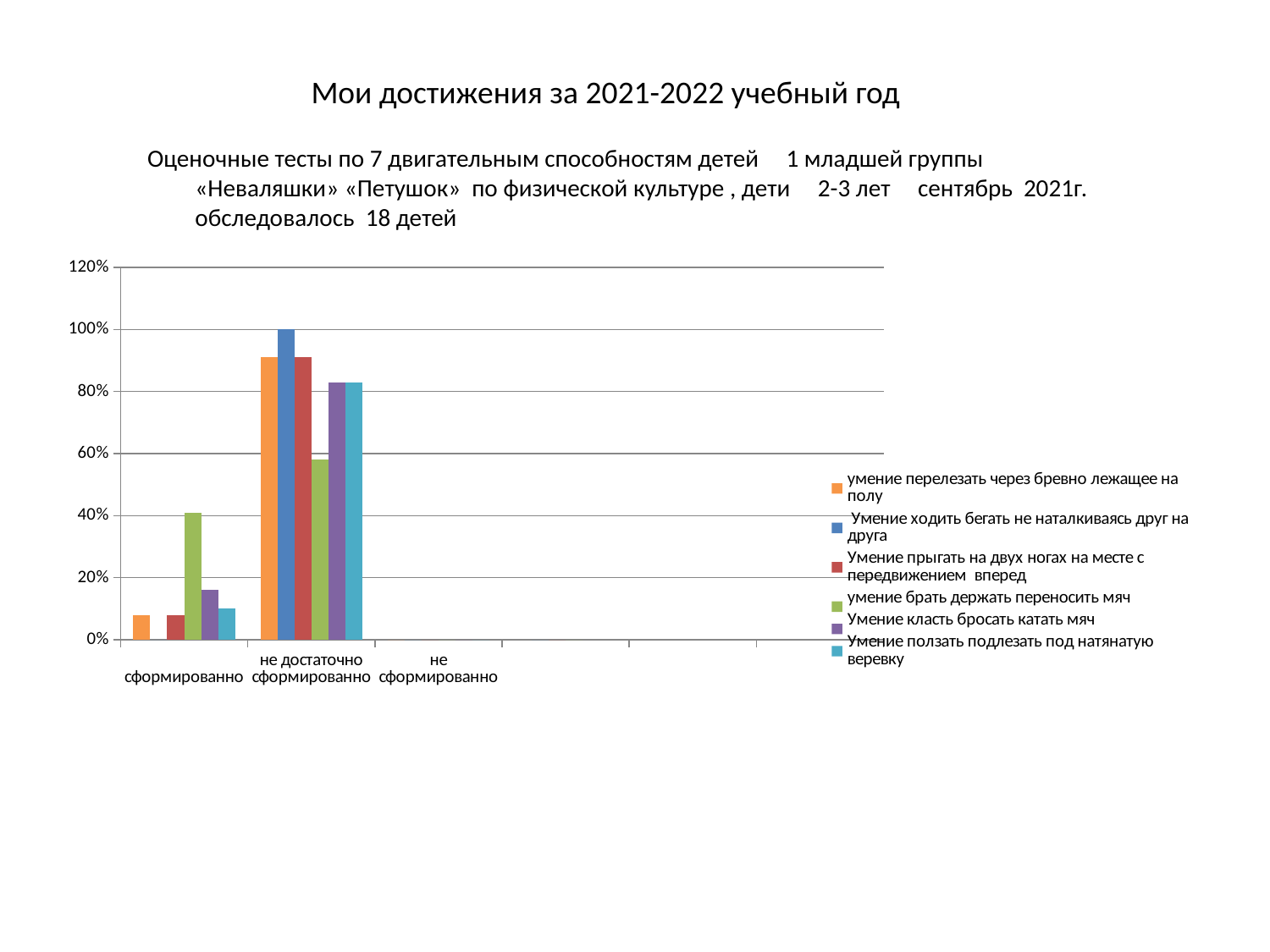
Which colour represents "умение брать держать переносить мяч" in the legend? green What is the value for "Умение ходить бегать не наталкиваясь друг на друга" in the "не достаточно сформированно" category? 100% How many series does the legend list? 6 Which series has the highest value in the "не достаточно сформированно" category? Умение ходить бегать не наталкиваясь друг на друга In the "сформированно" category, which is larger: "умение брать держать переносить мяч" or "Умение класть бросать катать мяч"? умение брать держать переносить мяч How many categories are shown on the x axis? 3 Which series has the highest value in the "сформированно" category? умение брать держать переносить мяч What kind of chart is shown on the slide? bar chart Which series has the lowest value in the "не достаточно сформированно" category? умение брать держать переносить мяч Is the value for "Умение класть бросать катать мяч" in the "не достаточно сформированно" category greater or less than 80%? greater Is the value for "умение перелезать через бревно лежащее на полу" in the "сформированно" category greater or less than 20%? less Is the value for "умение перелезать через бревно лежащее на полу" in the "не достаточно сформированно" category greater or less than 80%? greater